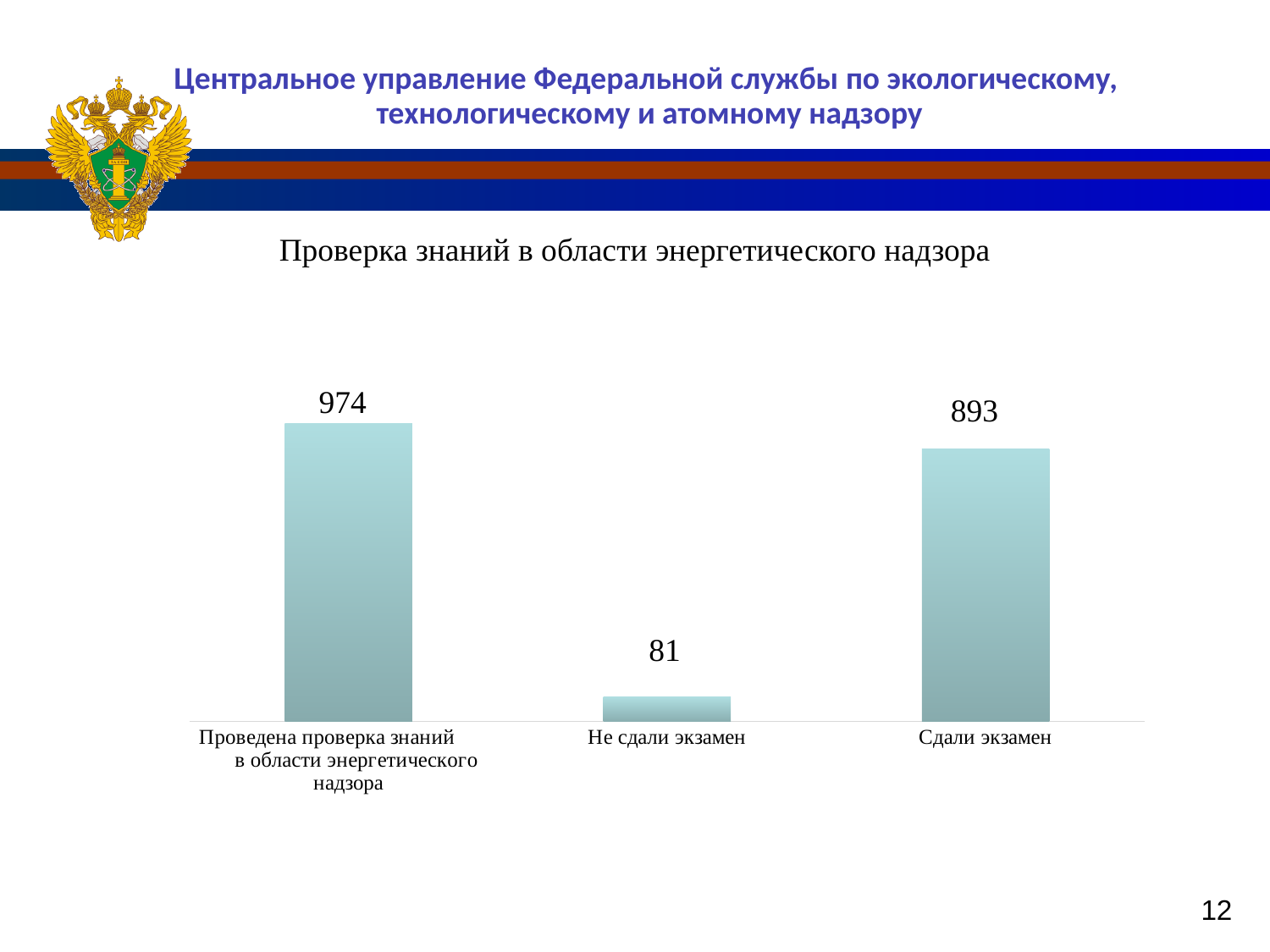
What is the value for 'Проведена проверка знаний в области энергетического надзора'? 974 What is the difference between the values for 'Проведена проверка знаний в области энергетического надзора' and 'Сдали экзамен'? 81 What is the sum of the values for 'Не сдали экзамен' and 'Сдали экзамен'? 974 Which category has the highest value? Проведена проверка знаний в области энергетического надзора What is the title of the chart? Проверка знаний в области энергетического надзора Which category has the lowest value? Не сдали экзамен What kind of chart is shown on the slide? bar chart What is the difference between the values for 'Сдали экзамен' and 'Не сдали экзамен'? 812 What is the value for 'Сдали экзамен'? 893 What is the value for 'Не сдали экзамен'? 81 Which is larger, the value for 'Сдали экзамен' or the value for 'Не сдали экзамен'? Сдали экзамен How many categories are shown in the chart? 3